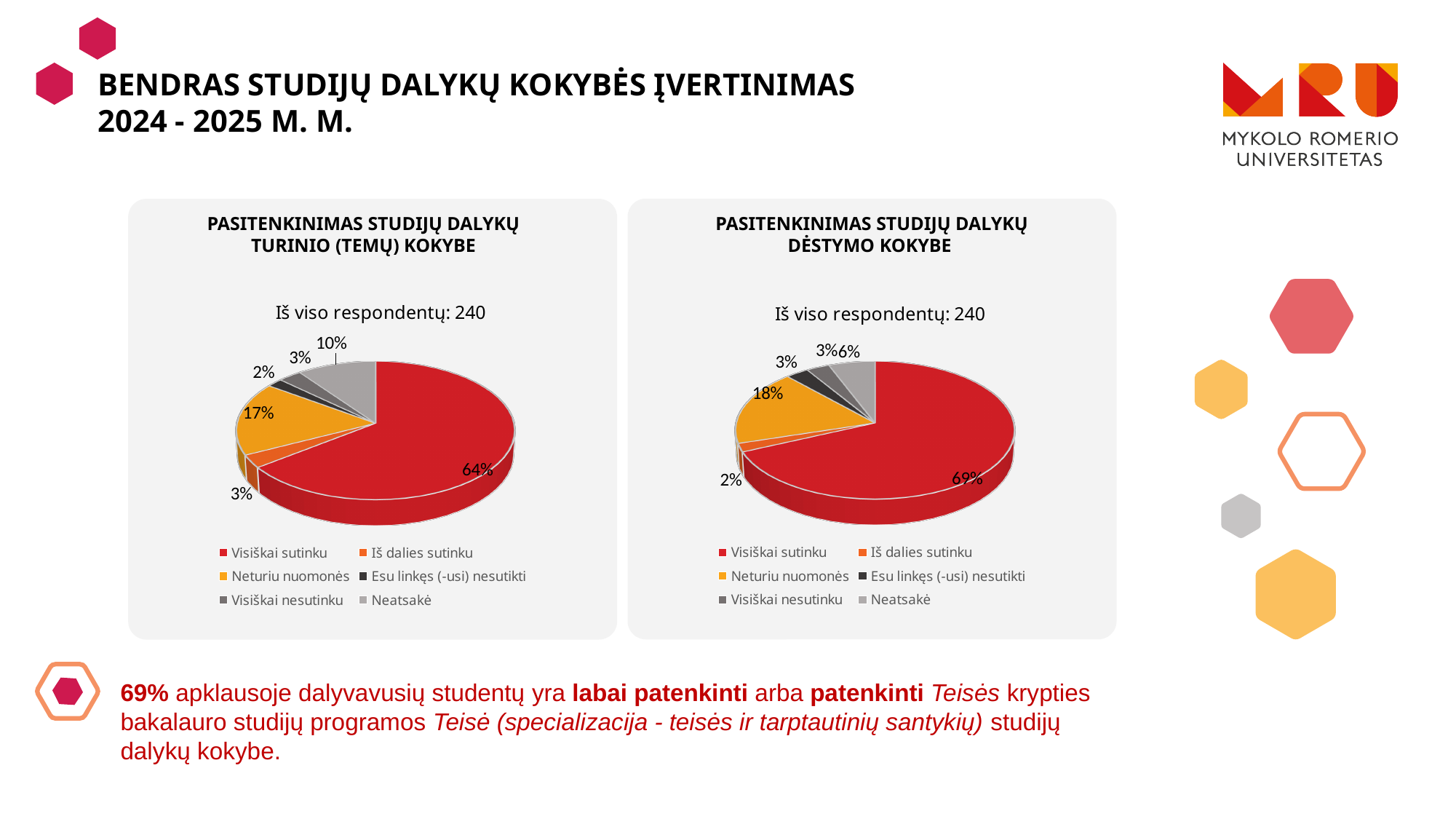
In the left chart (Pasitenkinimas studijų dalykų turinio (temų) kokybe), what percentage is shown for Neatsakė? 10% In the right chart (Pasitenkinimas studijų dalykų dėstymo kokybe), what percentage is shown for Neatsakė? 6% In the left chart (Pasitenkinimas studijų dalykų turinio (temų) kokybe), which category has the largest share? Visiškai sutinku Which is larger: the Neatsakė share in the left chart (Turinio (temų) kokybe) or in the right chart (Dėstymo kokybe)? Left chart (Turinio (temų) kokybe) In the left chart (Pasitenkinimas studijų dalykų turinio (temų) kokybe), what percentage is shown for Neturiu nuomonės? 17% In the right chart (Pasitenkinimas studijų dalykų dėstymo kokybe), what percentage is shown for Neturiu nuomonės? 18% In the left chart (Pasitenkinimas studijų dalykų turinio (temų) kokybe), what percentage is shown for Visiškai sutinku? 64% In the right chart (Pasitenkinimas studijų dalykų dėstymo kokybe), what percentage is shown for Visiškai sutinku? 69% What is the difference between the Visiškai sutinku share in the right chart (Dėstymo kokybe) and in the left chart (Turinio (temų) kokybe)? 5% What type of chart is used in the right chart (Pasitenkinimas studijų dalykų dėstymo kokybe)? Pie chart In the right chart (Pasitenkinimas studijų dalykų dėstymo kokybe), which category has the smallest share? Iš dalies sutinku How many categories does the legend of the left chart (Pasitenkinimas studijų dalykų turinio (temų) kokybe) list? 6